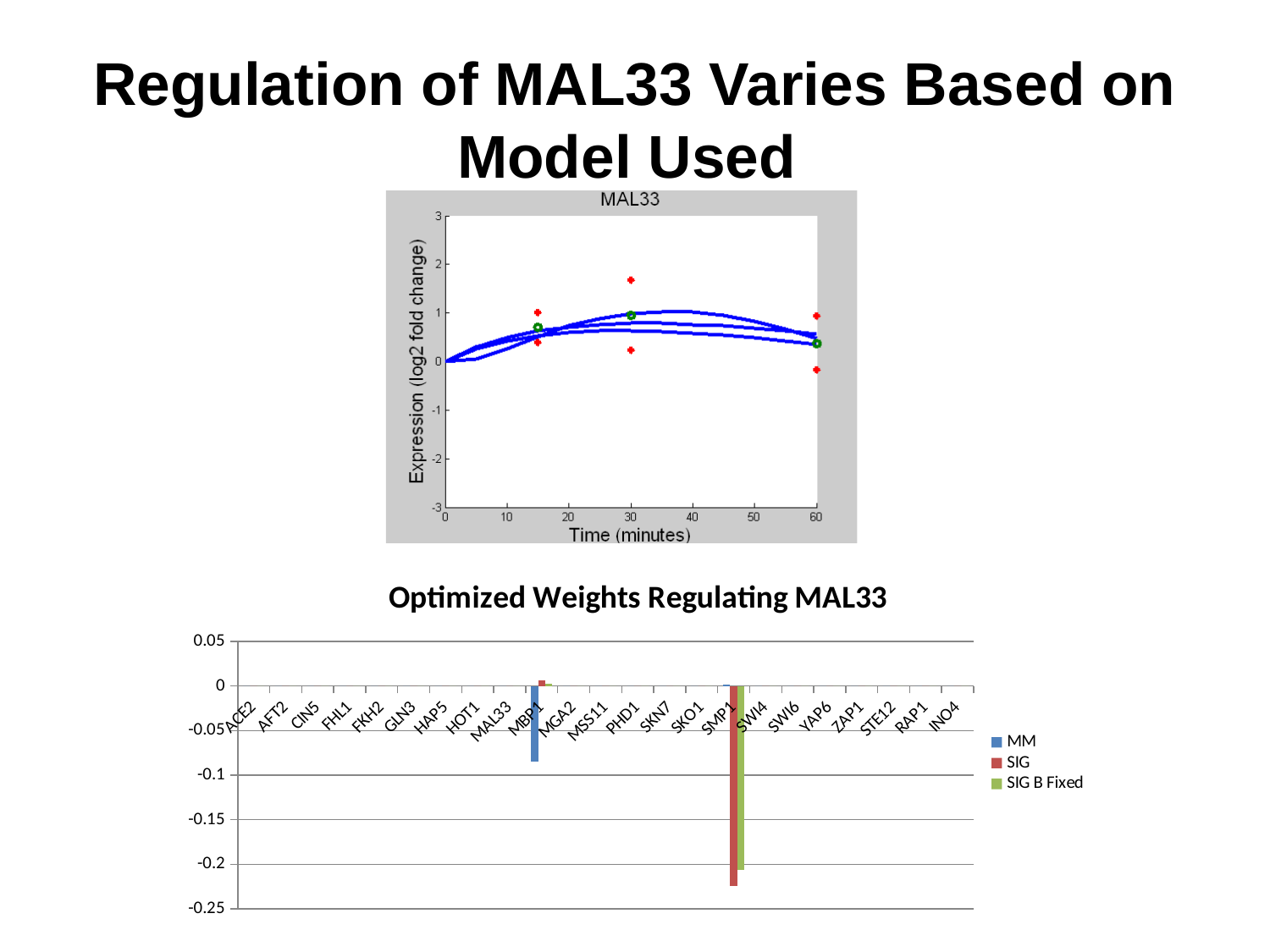
In the bottom chart, which is lower for SMP1, the SIG value or the SIG B Fixed value? SIG What kind of chart is the top chart titled MAL33? line chart In the bottom chart, is the SIG B Fixed value for SMP1 greater or less than -0.15? less In the bottom chart, which category has the lowest (most negative) SIG value? SMP1 In the bottom chart, is the SIG value for SMP1 greater or less than -0.2? less In the bottom chart, what are the names of the series in the legend? MM, SIG, SIG B Fixed In the top chart, what is the label of the x axis? Time (minutes) In the bottom chart, how many series does the legend list? 3 What kind of chart is the bottom chart, Optimized Weights Regulating MAL33? bar chart In the bottom chart, how many transcription factor categories are shown on the x axis? 23 What is the title of the bottom chart? Optimized Weights Regulating MAL33 In the bottom chart, is the MM value for MBP1 greater or less than -0.05? less